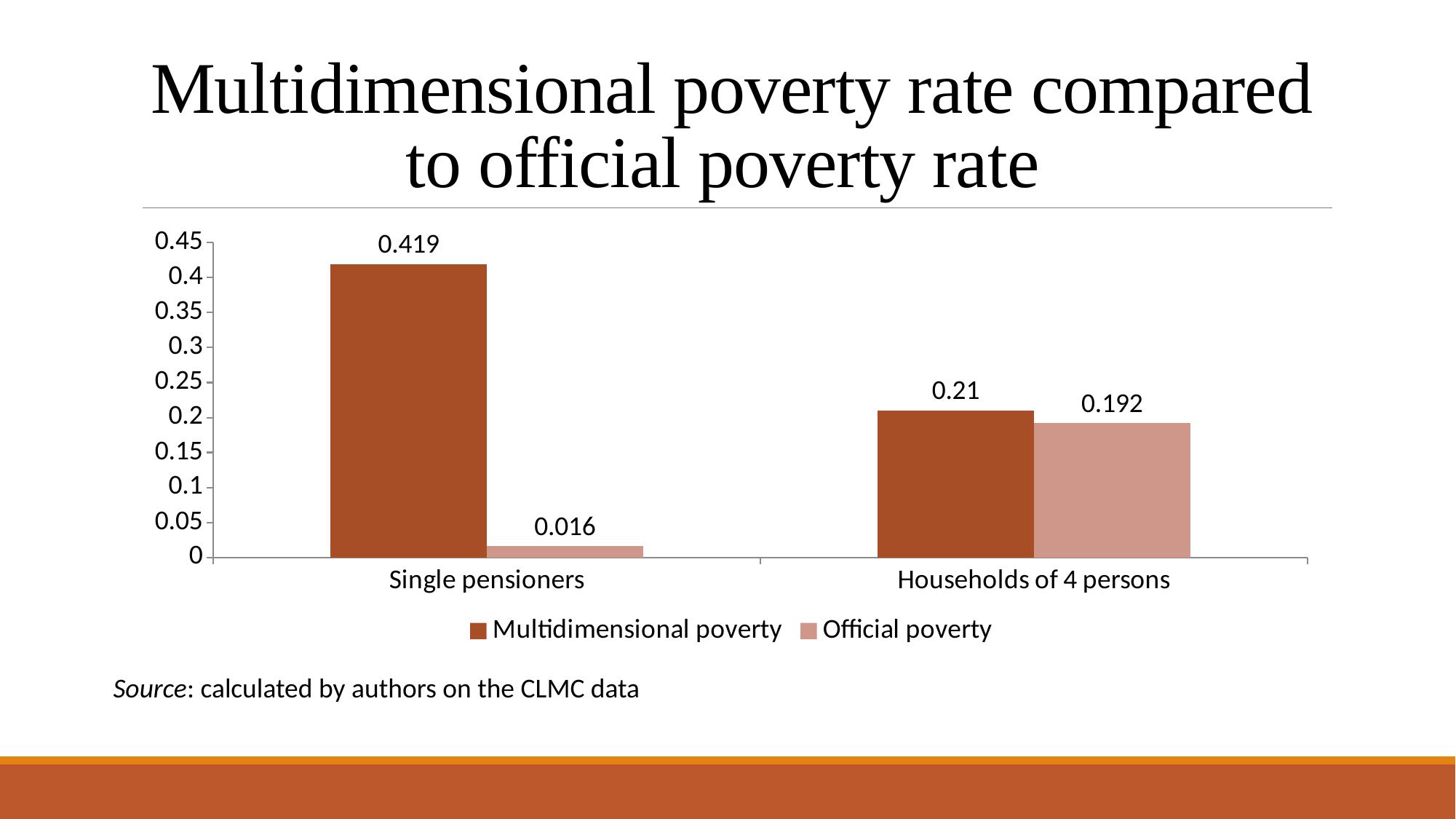
How many categories are shown on the x axis? 2 Which category has the highest multidimensional poverty rate? Single pensioners Which is larger for single pensioners: the multidimensional poverty rate or the official poverty rate? Multidimensional poverty How many series does the legend list? 2 Which category has the lowest official poverty rate? Single pensioners What is the official poverty rate for single pensioners? 0.016 What is the multidimensional poverty rate for households of 4 persons? 0.21 What is the difference between the multidimensional and official poverty rates for households of 4 persons? 0.018 What is the official poverty rate for households of 4 persons? 0.192 What kind of chart is shown on the slide? Bar chart What is the difference between the multidimensional and official poverty rates for single pensioners? 0.403 What is the multidimensional poverty rate for single pensioners? 0.419